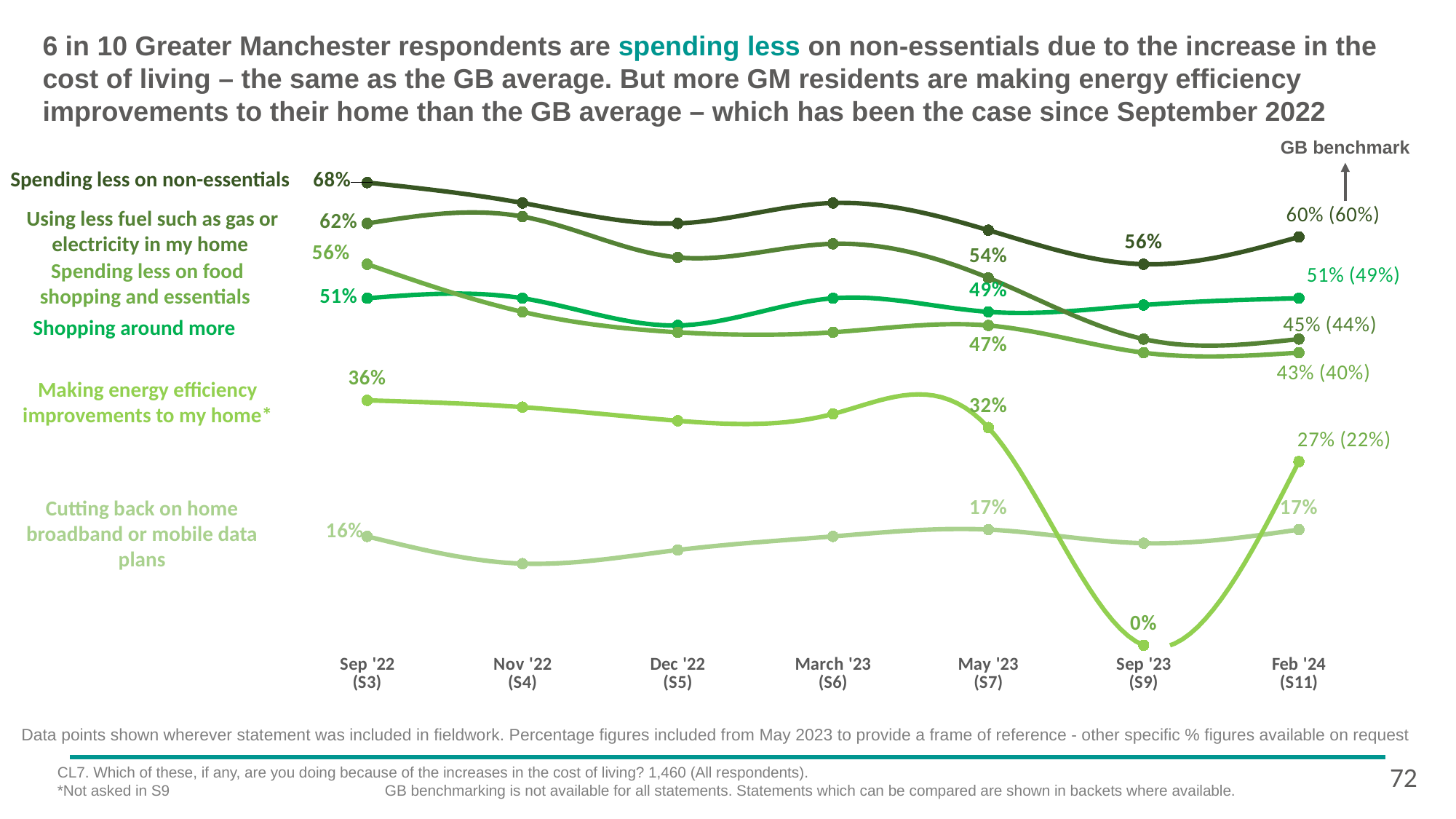
What percentage of respondents were spending less on non-essentials in Sep '22 (S3)? 68% By how many percentage points did 'Spending less on non-essentials' fall between Sep '22 and Feb '24? 8 percentage points What is the GB benchmark shown in brackets for making energy efficiency improvements to my home in Feb '24? 22% What percentage of respondents were spending less on non-essentials in Feb '24 (S11)? 60% How many statements (series) are plotted on the chart? 6 Which statement had the highest percentage in Sep '22 (S3)? Spending less on non-essentials What kind of chart is shown on the slide? Line chart In Feb '24, is the Greater Manchester value for making energy efficiency improvements (27%) higher or lower than the GB benchmark (22%)? Higher Which statement had the lowest percentage in Sep '22 (S3)? Cutting back on home broadband or mobile data plans How many survey waves (time points) are shown along the x axis? 7 What percentage of respondents were making energy efficiency improvements to their home in Sep '22 (S3)? 36% What percentage of respondents were cutting back on home broadband or mobile data plans in May '23 (S7)? 17%